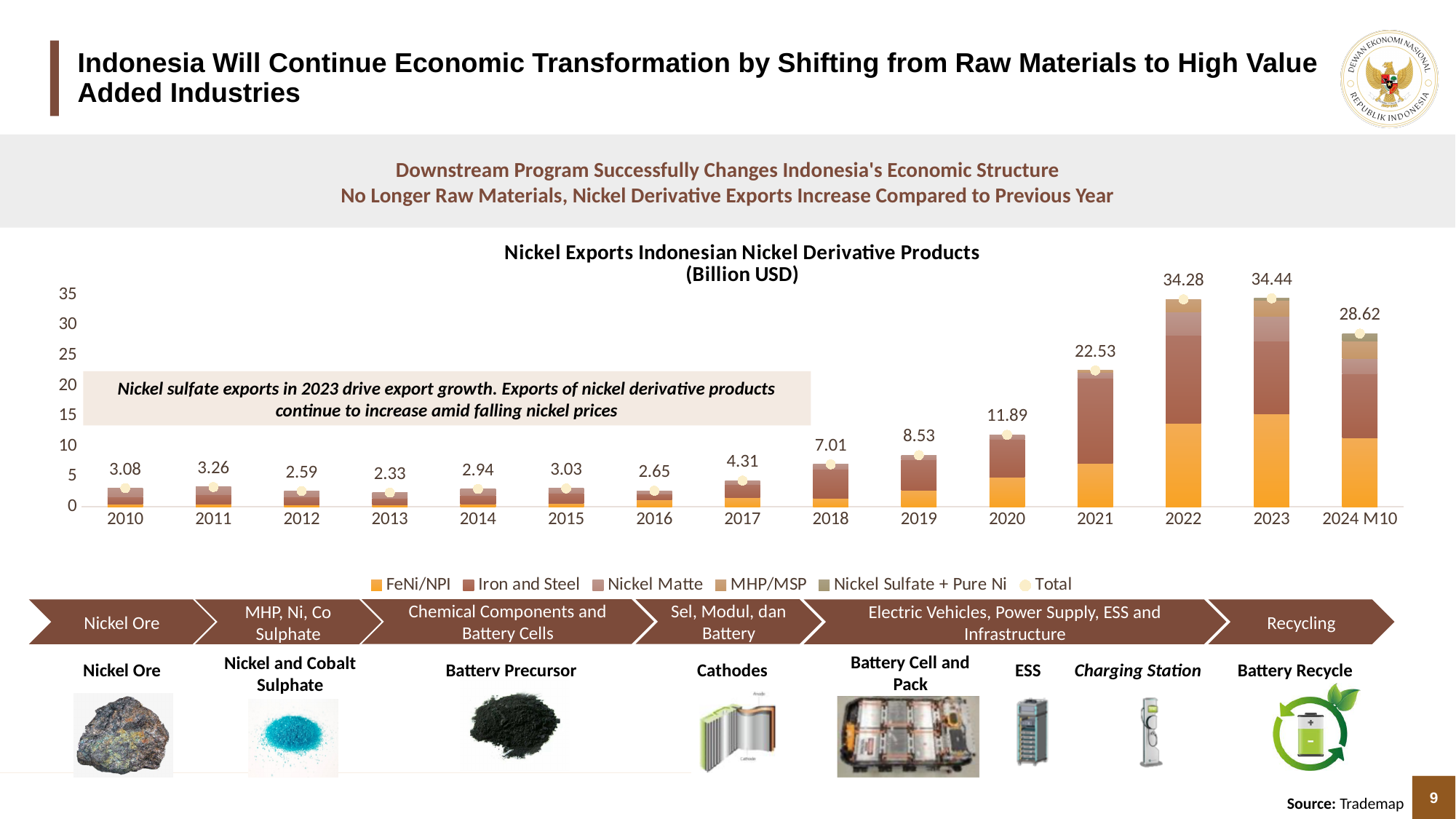
What is the total value labelled for 2018? 7.01 What is the difference between the total values for 2022 and 2021? 11.75 Is the FeNi/NPI segment for 2023 greater or less than 10? greater How many entries does the chart legend list? 6 Which year has the highest total nickel derivative export value? 2023 Which is larger, the total for 2019 or the total for 2020? 2020 How many time periods are shown on the x axis of the chart? 15 What is the total nickel derivative export value shown for 2022? 34.28 Which year has the lowest total nickel derivative export value? 2013 What kind of chart is used to show nickel derivative exports? Stacked bar chart What is the difference between the total values for 2023 and 2024 M10? 5.82 What is the total value labelled for 2024 M10? 28.62